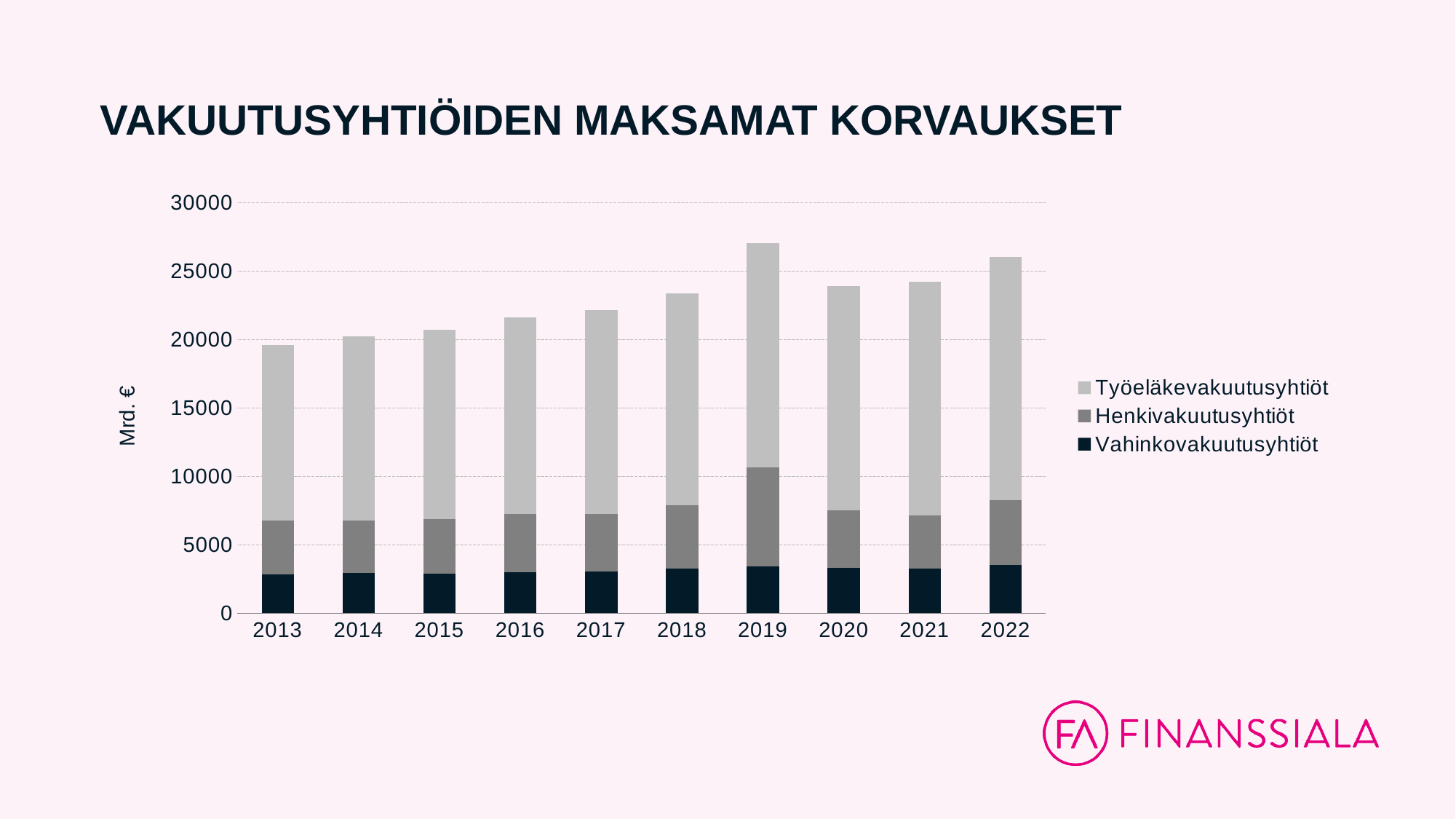
Which year has the larger total bar, 2019 or 2022? 2019 Do the total bars generally rise or fall from 2013 to 2019? Rise What kind of chart is shown on the slide? Stacked bar chart How many years are shown on the x axis of the chart? 10 Is the total bar for 2019 greater or less than 25000? greater Is the Vahinkovakuutusyhtiöt segment for 2022 greater or less than 5000? less Is the total bar for 2018 greater or less than 25000? less What is the label on the vertical axis of the chart? Mrd. € How many series does the chart's legend list? 3 Which year has the highest total bar in the chart? 2019 Which year has the lowest total bar in the chart? 2013